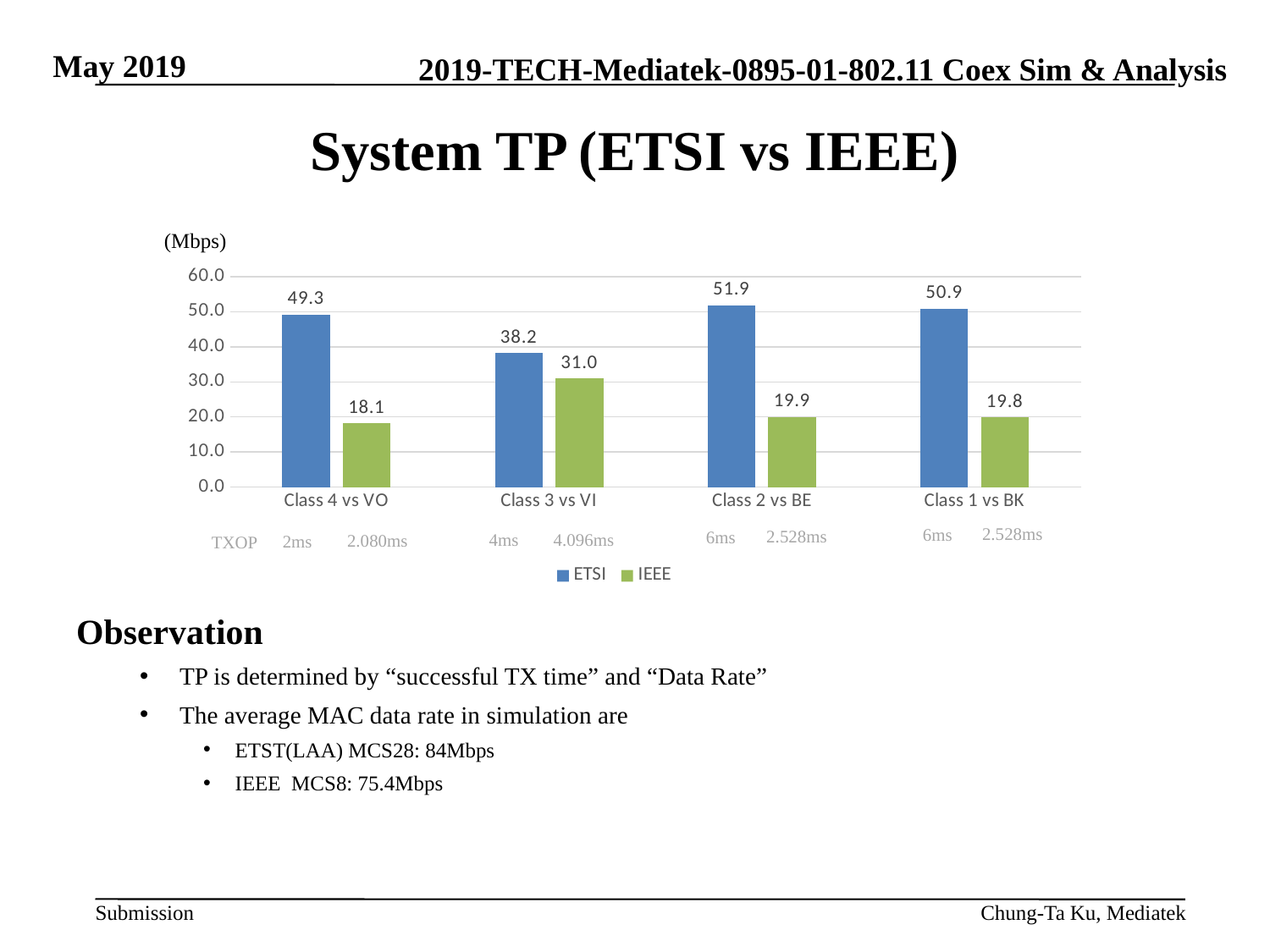
Which category has the highest ETSI value? Class 2 vs BE What kind of chart is shown on the slide? Bar chart What is the IEEE value for Class 1 vs BK? 19.8 What is the difference between the ETSI values for Class 2 vs BE and Class 3 vs VI? 13.7 How many categories are shown on the x axis? 4 What is the difference between the ETSI and IEEE values for Class 4 vs VO? 31.2 Which is larger, the IEEE value for Class 3 vs VI or the IEEE value for Class 2 vs BE? Class 3 vs VI Which category has the lowest IEEE value? Class 4 vs VO What is the IEEE value for Class 3 vs VI? 31.0 What is the ETSI value for Class 4 vs VO? 49.3 How many series does the legend list? 2 What unit is shown on the y axis of the chart? Mbps